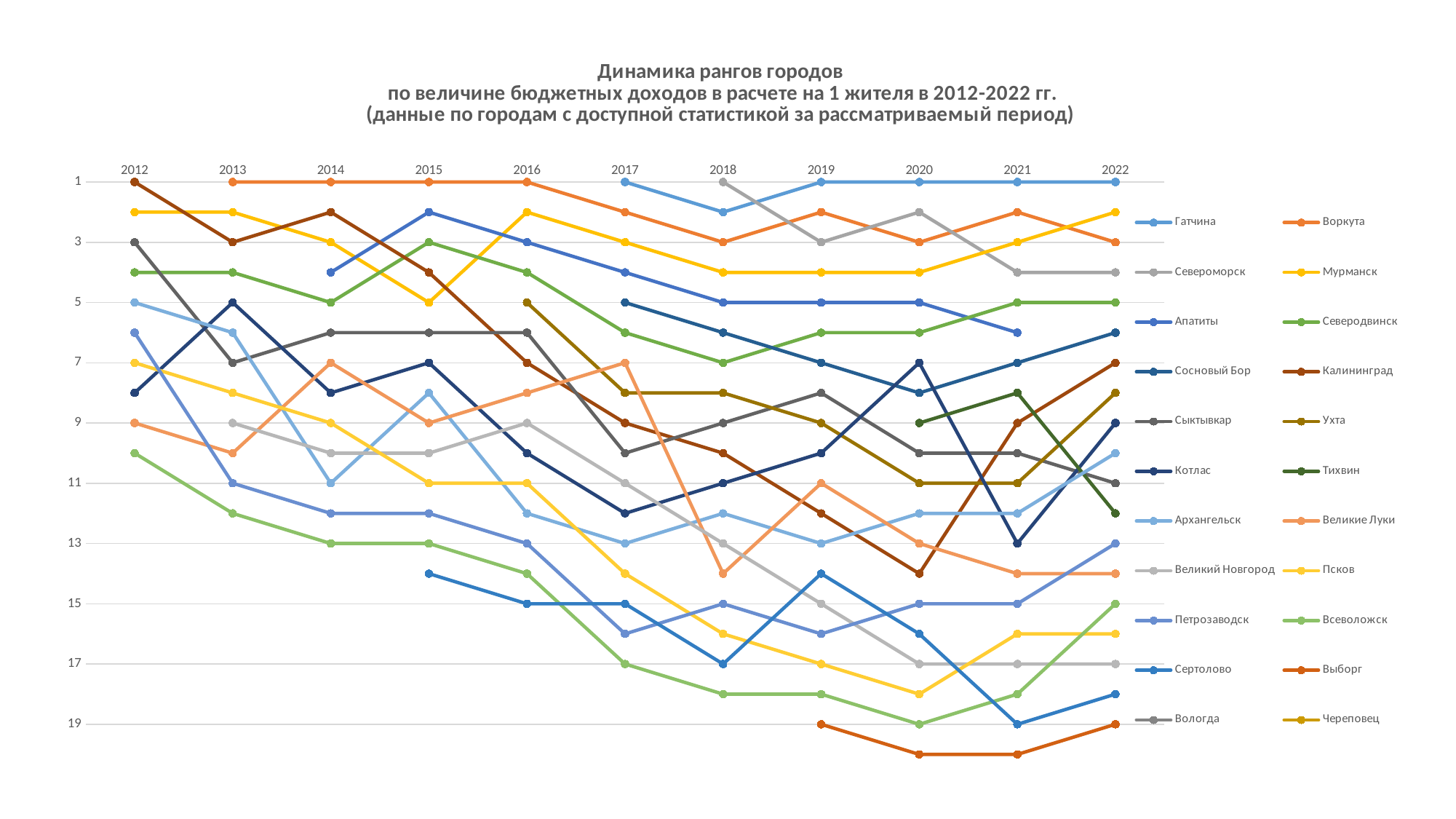
What is the difference between the rank of Выборг and the rank of Гатчина in 2022? 18 What rank does Гатчина hold in 2022? 1 What kind of chart is shown on the slide? line chart What rank does Северодвинск hold in 2022? 5 How many cities does the legend list? 22 Which city is ranked 1st in 2022? Гатчина How many years are plotted along the x axis? 11 What rank does Всеволожск hold in 2020? 19 Does the rank number of Всеволожск rise or fall from 2012 to 2020? rise What rank does Выборг hold in 2022? 19 What rank does Сертолово hold in 2021? 19